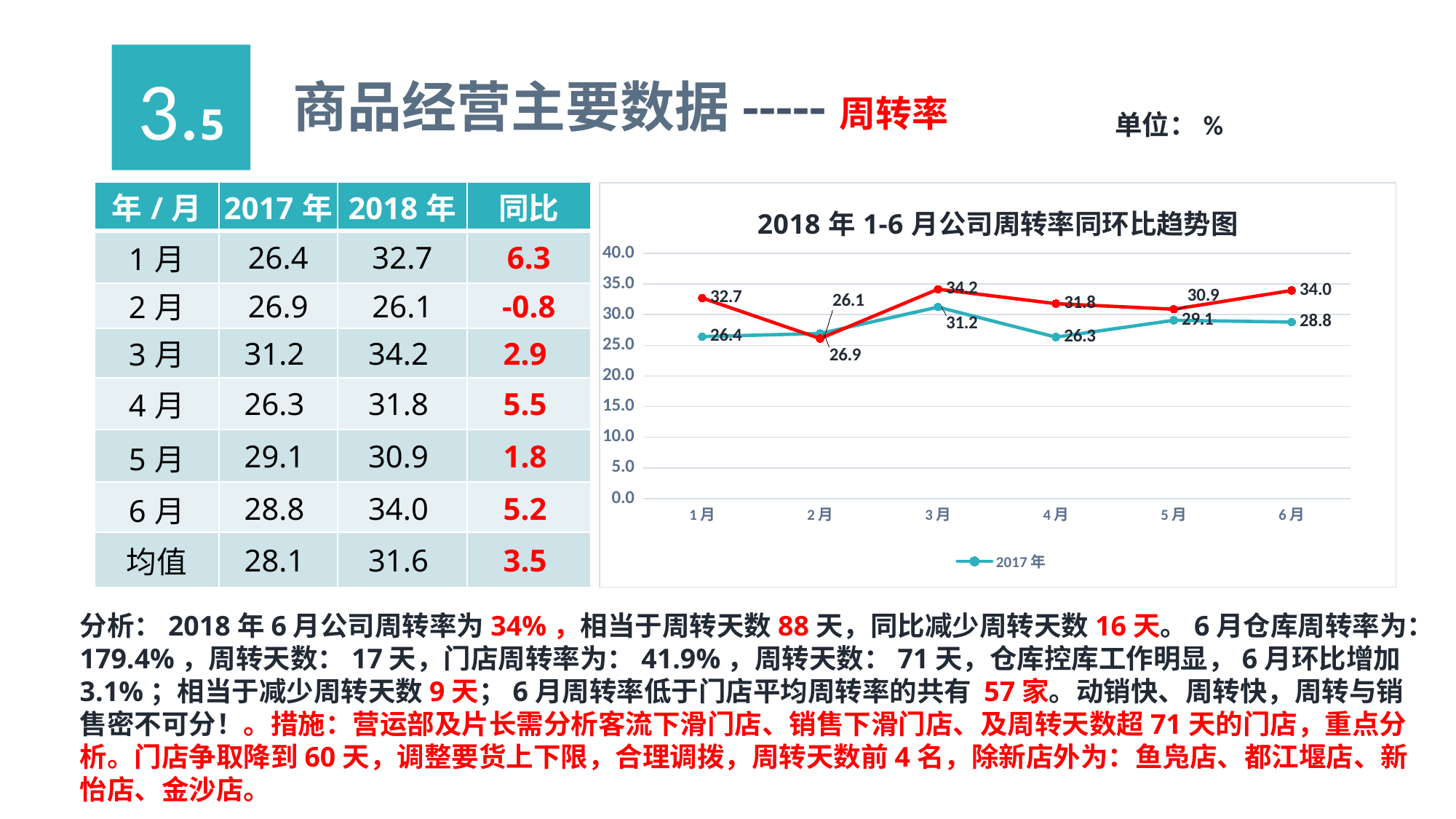
How many months are plotted along the x axis of the chart? 6 What kind of chart is shown on the slide? line chart What is the chart's title? 2018年1-6月公司周转率同环比趋势图 What is the value of the red (2018年) line for 6月? 34.0 How many entries does the chart's legend list? 1 In 4月, which line has the larger value, the red (2018年) line or the teal (2017年) line? red (2018年) In which month does the red (2018年) line reach its lowest value? 2月 Does the red (2018年) line rise or fall from 5月 to 6月? rise Is the value of the 2017年 line for 5月 greater or less than 30.0? less In which month does the red (2018年) line reach its highest value? 3月 What is the value of the 2017年 (teal) line for 3月? 31.2 What is the difference between the red line and the teal line in 1月? 6.3